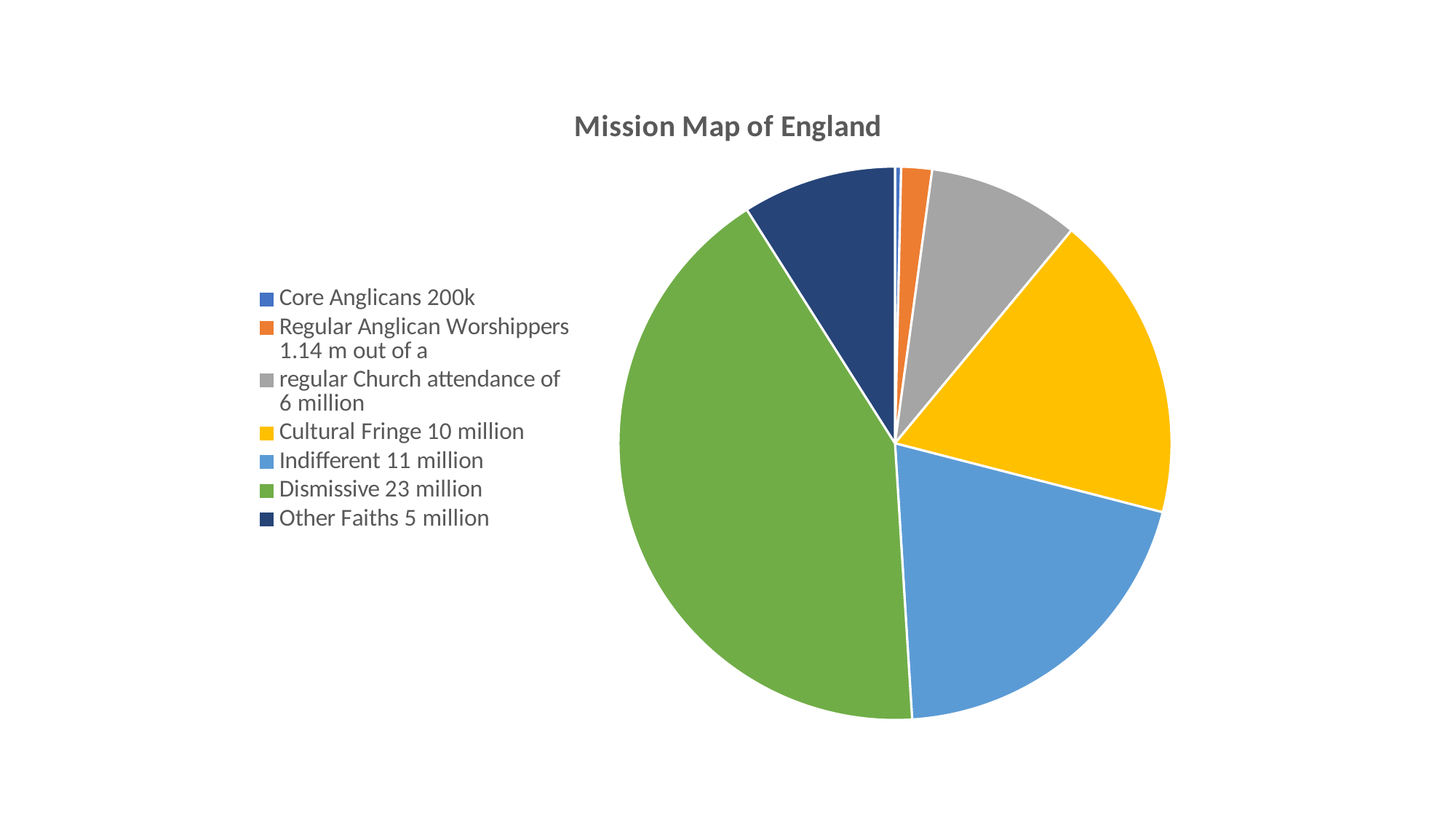
What is the value given for Other Faiths? 5 million Which is larger, Indifferent or Cultural Fringe? Indifferent Which category has the smallest slice of the pie? Core Anglicans What is the title of the chart? Mission Map of England What kind of chart is shown on the slide? pie chart How many categories does the pie chart have? 7 Which category has the largest slice of the pie? Dismissive What colour is the Dismissive slice? green What is the value given for Cultural Fringe? 10 million What is the value given for Core Anglicans? 200k What is the value given for Dismissive? 23 million What is the difference between the Dismissive and Indifferent values? 12 million